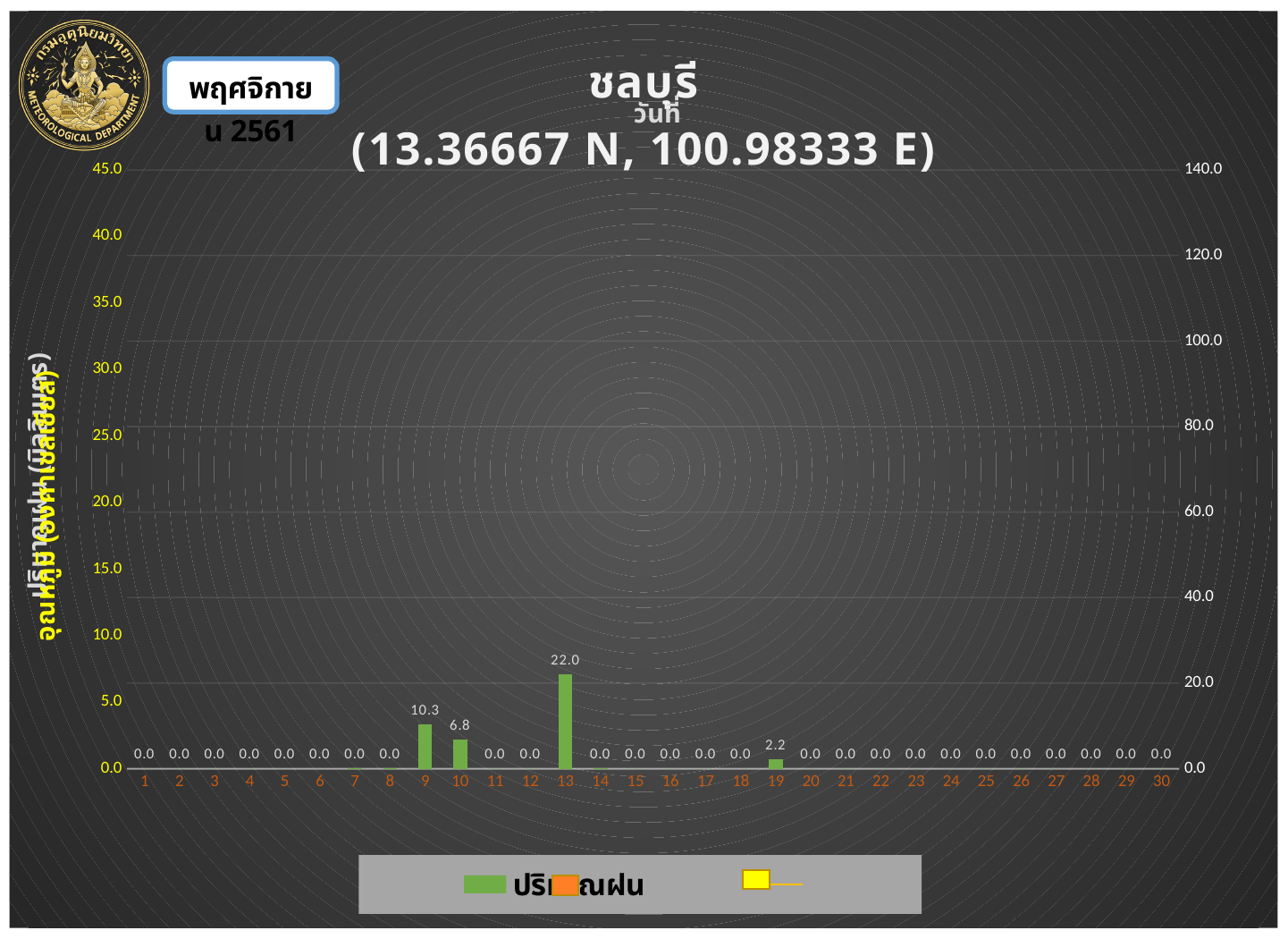
Which day has the highest rainfall value? 13 What is the rainfall value shown for day 10? 6.8 What kind of chart is shown on the slide? bar chart What is the rainfall value shown for day 5? 0.0 What is the difference between the rainfall values for day 13 and day 9? 11.7 What is the difference between the rainfall values for day 9 and day 10? 3.5 What is the title of the chart? ชลบุรี (13.36667 N, 100.98333 E) How many days are shown on the x axis? 30 What is the rainfall value shown for day 13? 22.0 Which is larger, the rainfall value for day 10 or for day 19? day 10 What is the rainfall value shown for day 9? 10.3 What is the rainfall value shown for day 19? 2.2